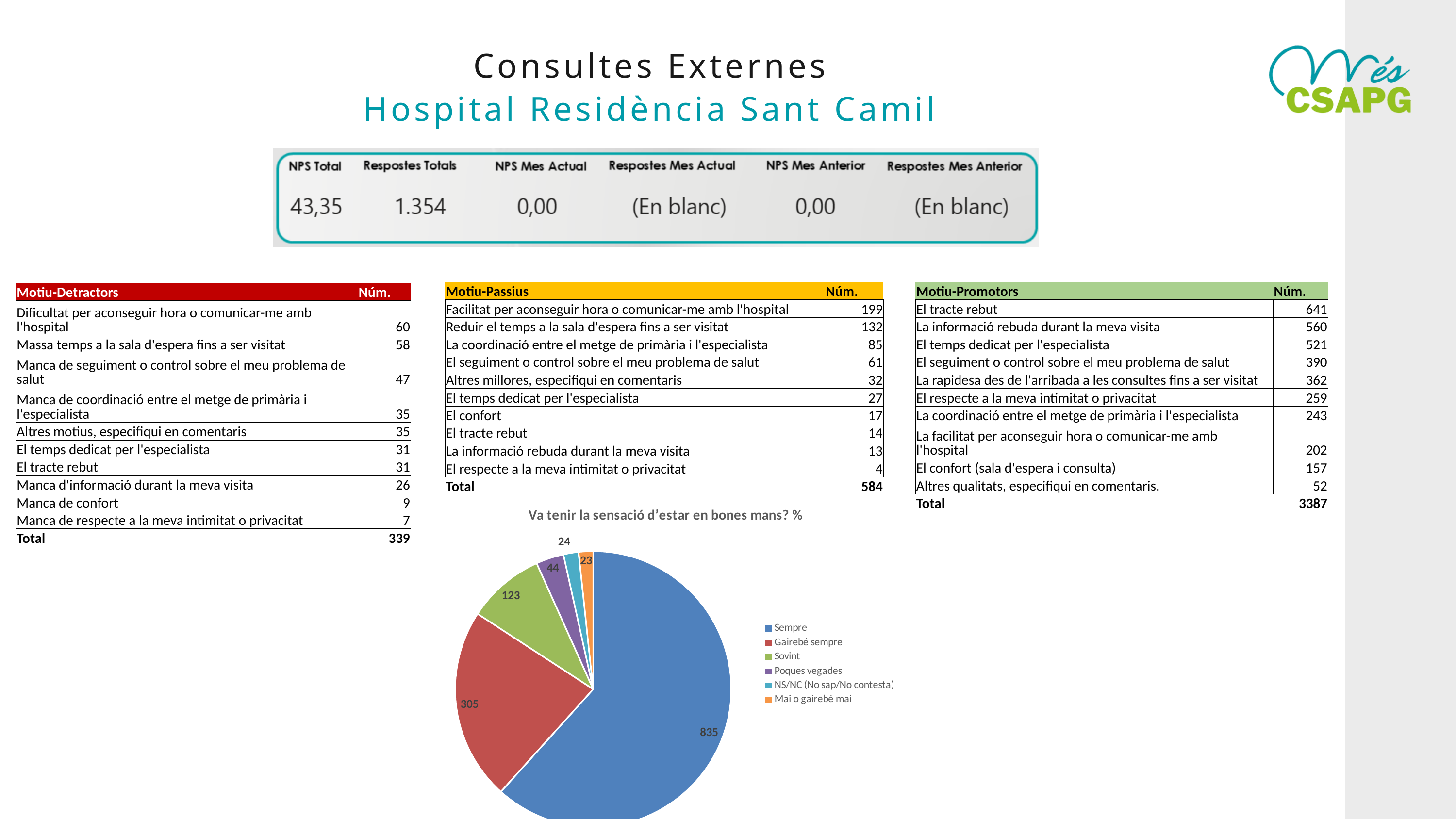
In the pie chart, what is the value for "Sovint"? 123 In the pie chart, what is the value for "Sempre"? 835 In the pie chart, what is the difference between the values for "Sovint" and "Poques vegades"? 79 In the pie chart, what is the value for "Gairebé sempre"? 305 Which category has the smallest slice in the pie chart? Mai o gairebé mai In the pie chart, what is the difference between the values for "Sempre" and "Gairebé sempre"? 530 In the pie chart, which is larger: "Sovint" or "Poques vegades"? Sovint What kind of chart is shown on the slide? pie chart In the pie chart, what is the value for "NS/NC (No sap/No contesta)"? 24 What is the title of the pie chart? Va tenir la sensació d'estar en bones mans? % Which category has the largest slice in the pie chart? Sempre How many categories does the pie chart legend list? 6